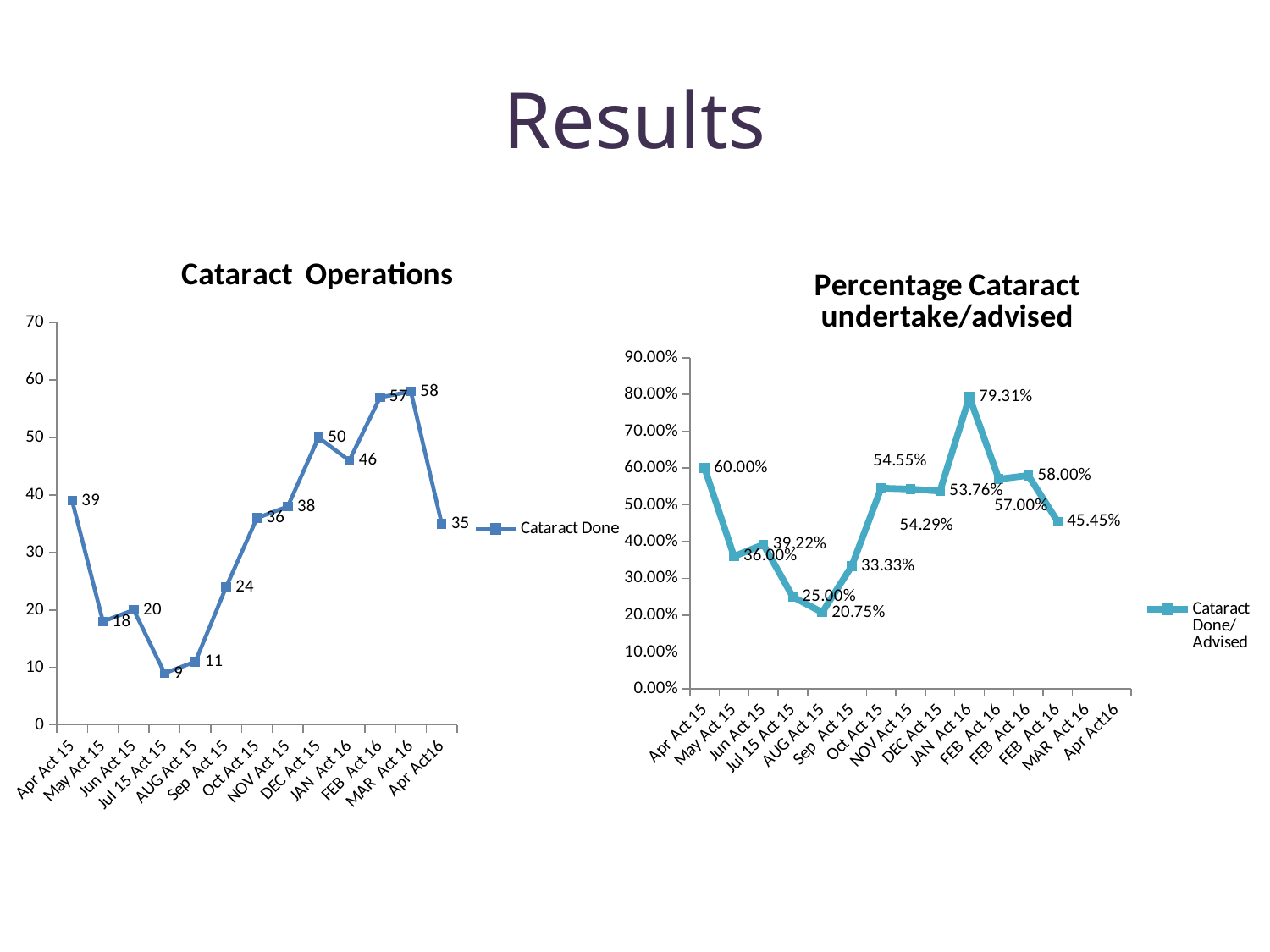
In the Cataract Operations chart, which category has the lowest value? Jul 15 Act 15 What kind of chart is the Cataract Operations chart? Line chart In the Cataract Operations chart, which is larger, the value for DEC Act 15 or the value for JAN Act 16? DEC Act 15 In the Cataract Operations chart, what is the value for Apr Act 15? 39 In the Cataract Operations chart, what is the value for DEC Act 15? 50 How many categories are shown on the x axis of the Cataract Operations chart? 13 In the Cataract Operations chart, what is the difference between the values for MAR Act 16 and Apr Act16? 23 In the Percentage Cataract undertake/advised chart, what is the lowest value shown? 20.75% In the Percentage Cataract undertake/advised chart, what is the highest value shown? 79.31% In the Cataract Operations chart, which category has the highest value? MAR Act 16 In the Percentage Cataract undertake/advised chart, what is the value for Apr Act 15? 60.00% What series name does the legend of the Percentage Cataract undertake/advised chart show? Cataract Done/Advised